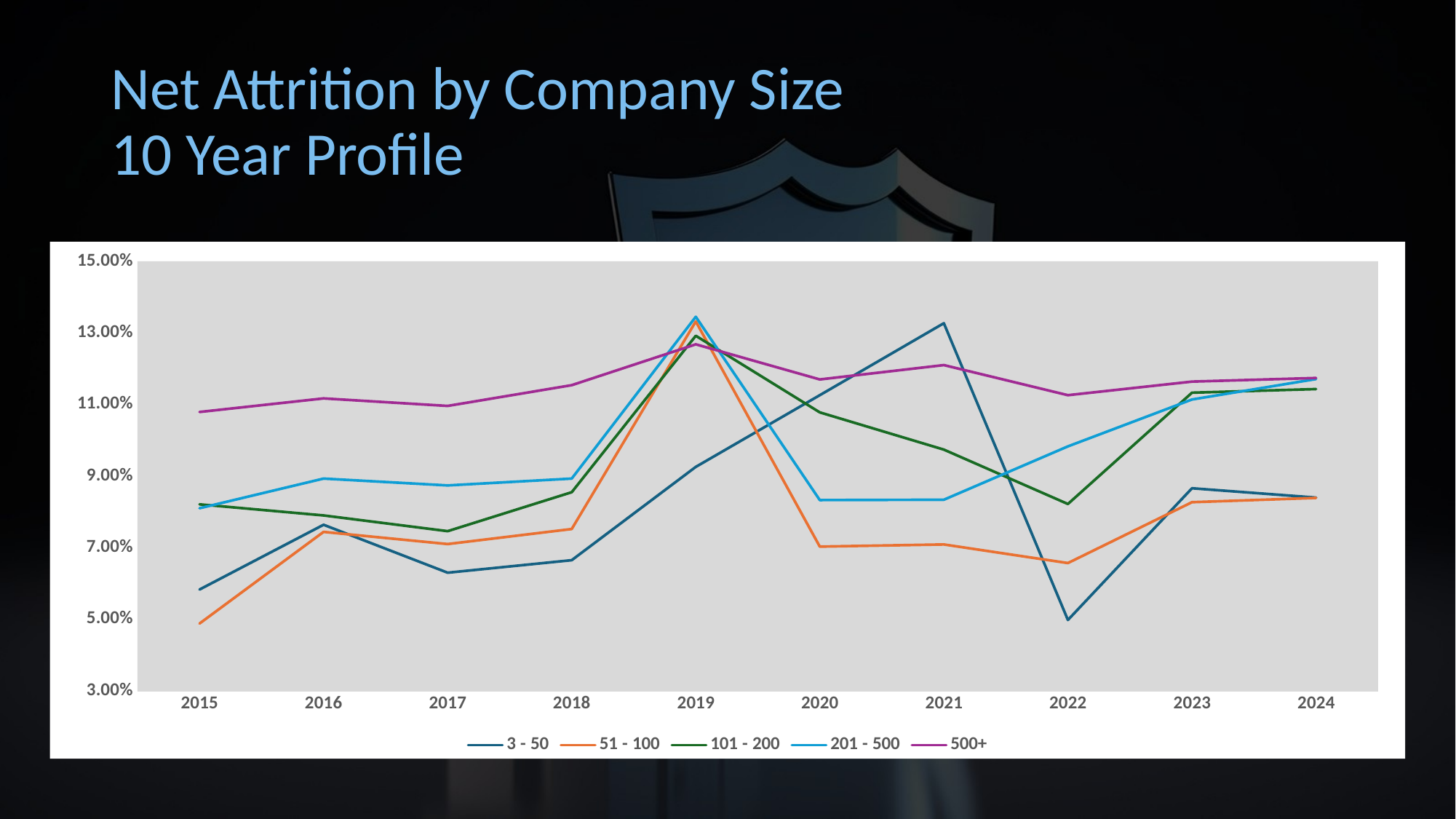
What kind of chart is shown on the slide? Line chart In which year does the 51 - 100 series reach its highest value? 2019 Is the value for the 500+ series in 2015 greater or less than 9.00%? greater Does the 500+ series rise or fall from 2015 to 2019? rise Which series has the lowest value in 2015? 51 - 100 How many years are shown along the x axis? 10 Is the value for the 51 - 100 series in 2020 greater or less than 9.00%? less How many series does the legend list? 5 Which series has the highest value in 2021? 3 - 50 In which year does the 3 - 50 series reach its lowest value? 2022 In 2020, which is larger: the 101 - 200 series or the 51 - 100 series? 101 - 200